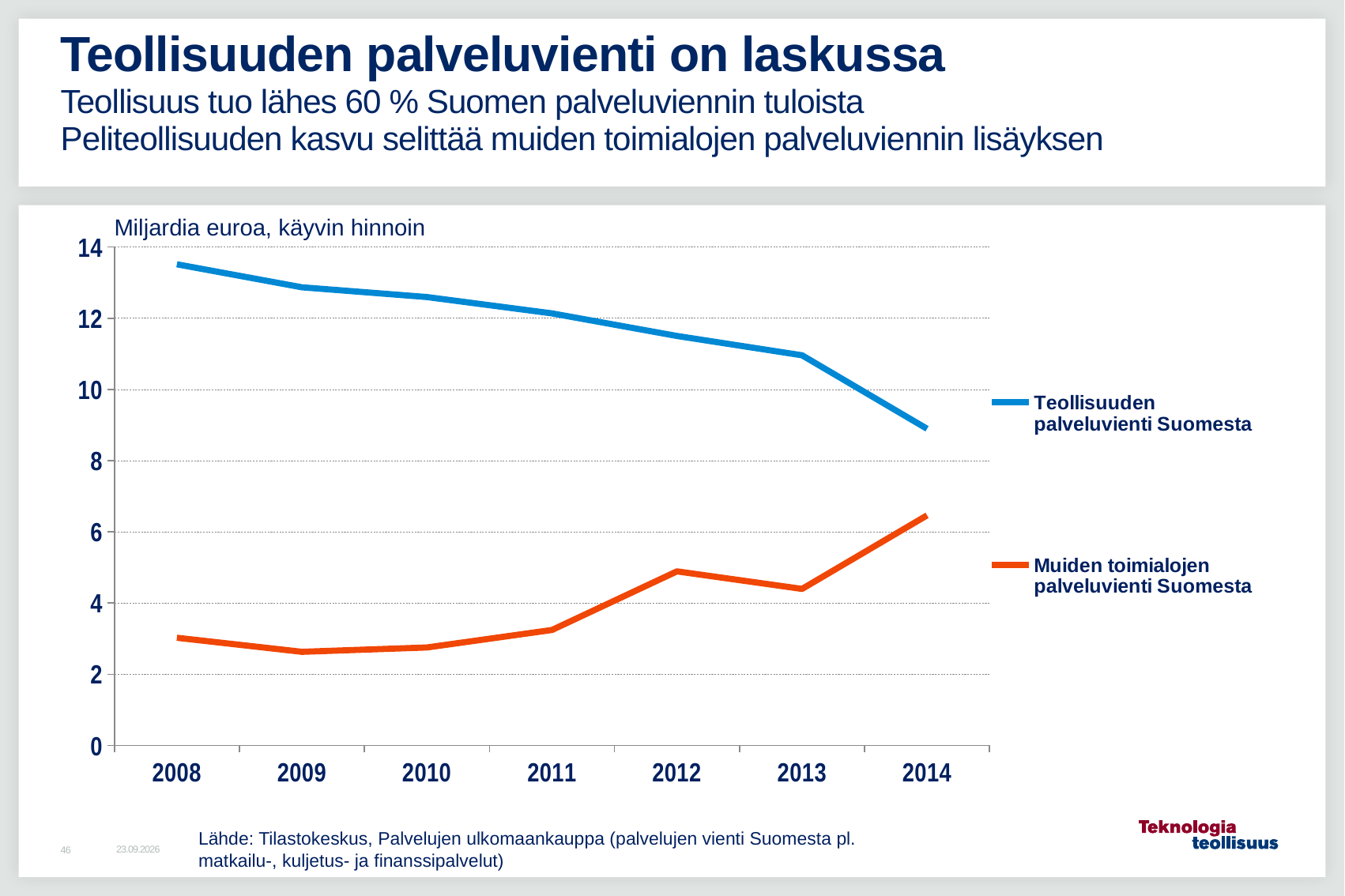
What unit label is shown above the y axis? Miljardia euroa, käyvin hinnoin How many years are shown on the x axis? 7 In which year is Muiden toimialojen palveluvienti Suomesta highest? 2014 How many series does the legend list? 2 What kind of chart is shown on the slide? Line chart Is the value for Muiden toimialojen palveluvienti Suomesta in 2014 greater or less than 6? greater Is the value for Teollisuuden palveluvienti Suomesta in 2014 greater or less than 10? less In which year is Teollisuuden palveluvienti Suomesta lowest? 2014 Is the value for Teollisuuden palveluvienti Suomesta in 2008 greater or less than 12? greater In which year is Teollisuuden palveluvienti Suomesta highest? 2008 Which is larger for Muiden toimialojen palveluvienti Suomesta: the value in 2012 or in 2013? 2012 Does the line for Teollisuuden palveluvienti Suomesta rise or fall from 2008 to 2014? Fall